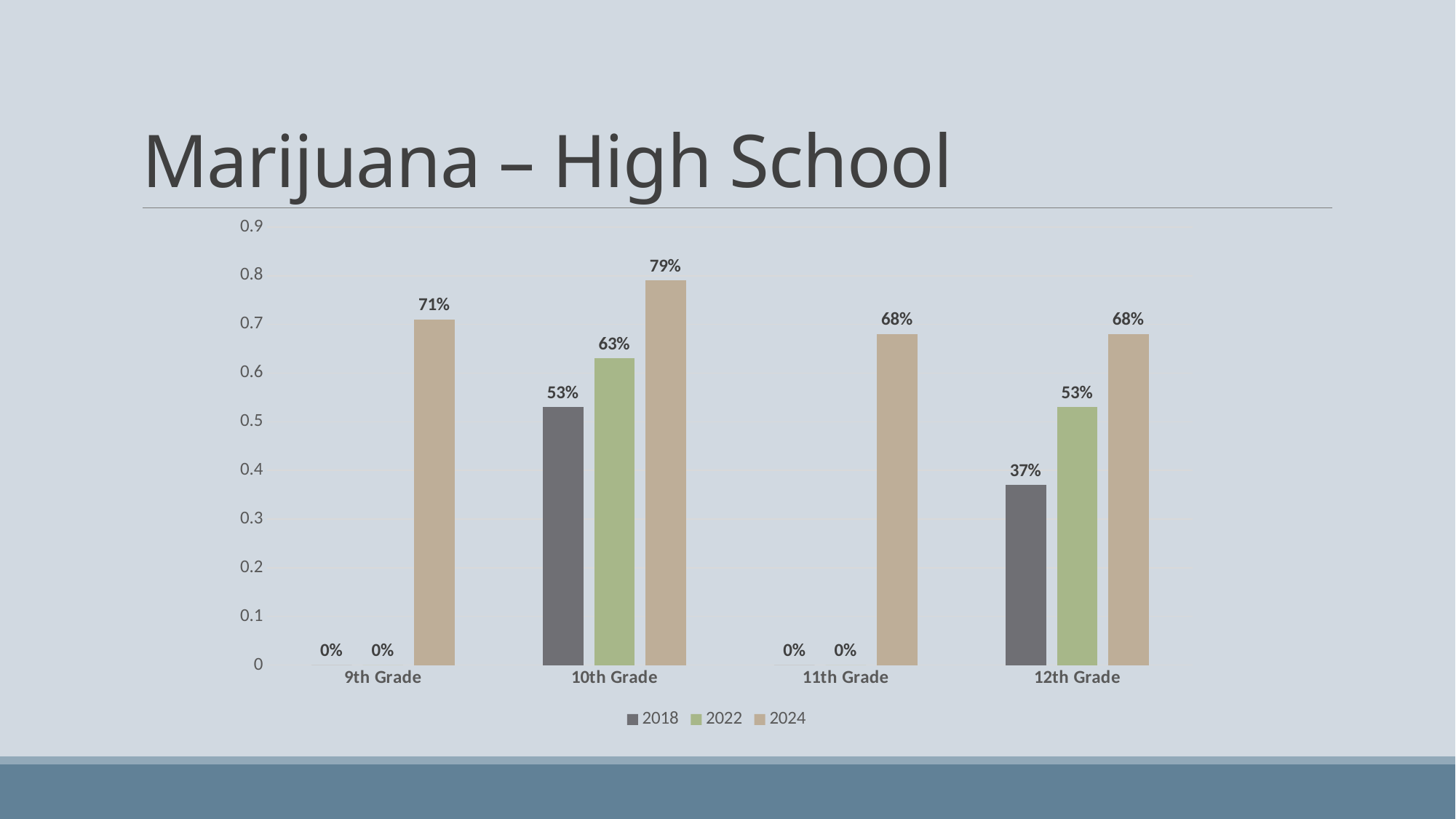
What is the value for 9th Grade in the 2024 series? 71% Which grade has the highest value in the 2024 series? 10th Grade How many grade categories are shown on the x axis? 4 What is the difference between the 2024 and 2018 values for 10th Grade? 26% Which grade has the lowest non-zero value in the 2018 series? 12th Grade What is the value for 12th Grade in the 2022 series? 53% Which is larger for 12th Grade: the 2022 value or the 2024 value? 2024 What is the value for 12th Grade in the 2018 series? 37% What is the value for 10th Grade in the 2024 series? 79% How many series does the legend list? 3 What is the title of the slide? Marijuana – High School What kind of chart is shown on the slide? Bar chart